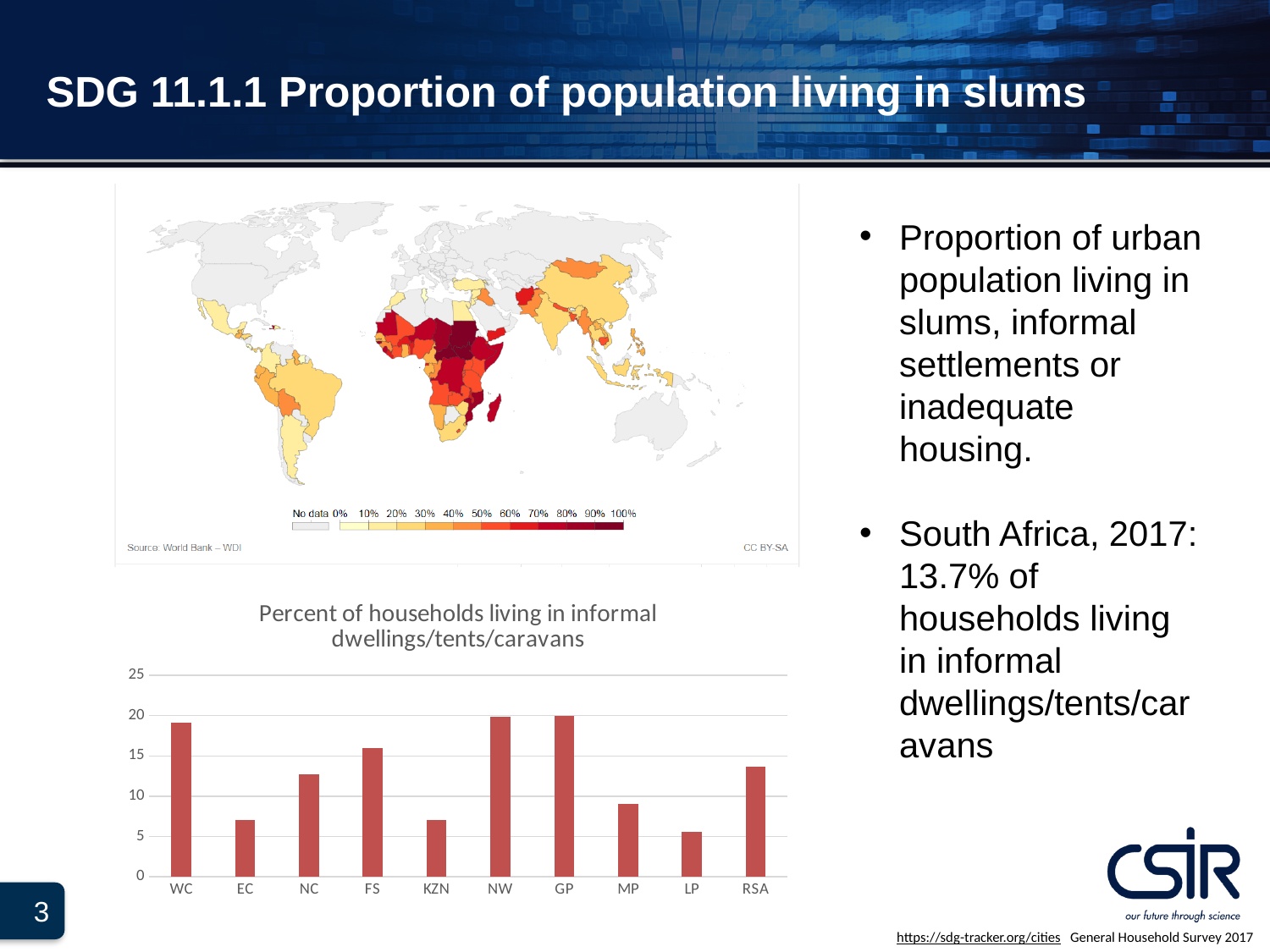
In the bar chart 'Percent of households living in informal dwellings/tents/caravans', is the value for KZN greater or less than 10? less What is the title of the bar chart at the bottom left of the slide? Percent of households living in informal dwellings/tents/caravans How many categories are shown on the x axis of the bar chart 'Percent of households living in informal dwellings/tents/caravans'? 10 According to the slide, what is the value for RSA in the bar chart 'Percent of households living in informal dwellings/tents/caravans'? 13.7% In the bar chart 'Percent of households living in informal dwellings/tents/caravans', which is larger, WC or EC? WC In the bar chart 'Percent of households living in informal dwellings/tents/caravans', is the value for NC greater or less than 10? greater What source is cited for the world map at the top left of the slide? World Bank – WDI What type of chart is the chart titled 'Percent of households living in informal dwellings/tents/caravans'? bar chart In the bar chart 'Percent of households living in informal dwellings/tents/caravans', is the value for WC greater or less than 15? greater In the bar chart 'Percent of households living in informal dwellings/tents/caravans', which is larger, MP or FS? FS In the bar chart 'Percent of households living in informal dwellings/tents/caravans', which category has the lowest value? LP